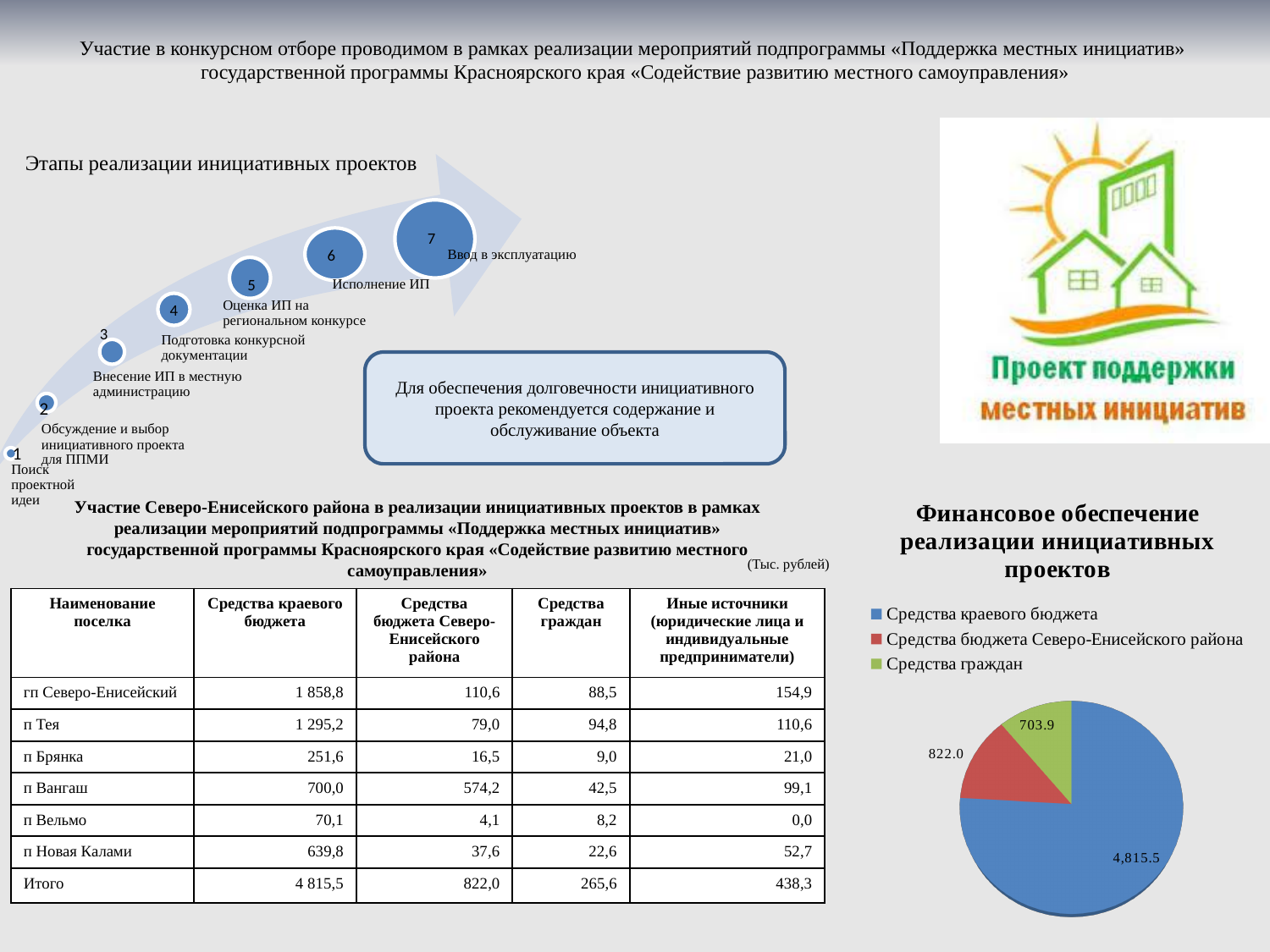
Which slice of the pie chart is the smallest? Средства граждан How many entries does the legend of the pie chart list? 3 Which slice of the pie chart is the largest? Средства краевого бюджета In the pie chart, which is larger: "Средства бюджета Северо-Енисейского района" or "Средства граждан"? Средства бюджета Северо-Енисейского района In the pie chart, what is the difference between "Средства бюджета Северо-Енисейского района" and "Средства граждан"? 118.1 In the pie chart, what is the difference between "Средства краевого бюджета" and "Средства бюджета Северо-Енисейского района"? 3,993.5 In the pie chart, what is the value for "Средства граждан"? 703.9 In the pie chart, what is the value for "Средства бюджета Северо-Енисейского района"? 822.0 What kind of chart is shown under the title "Финансовое обеспечение реализации инициативных проектов"? pie chart How many slices does the pie chart have? 3 In the pie chart, what is the value for "Средства краевого бюджета"? 4,815.5 In the pie chart, what colour is the slice for "Средства граждан"? green